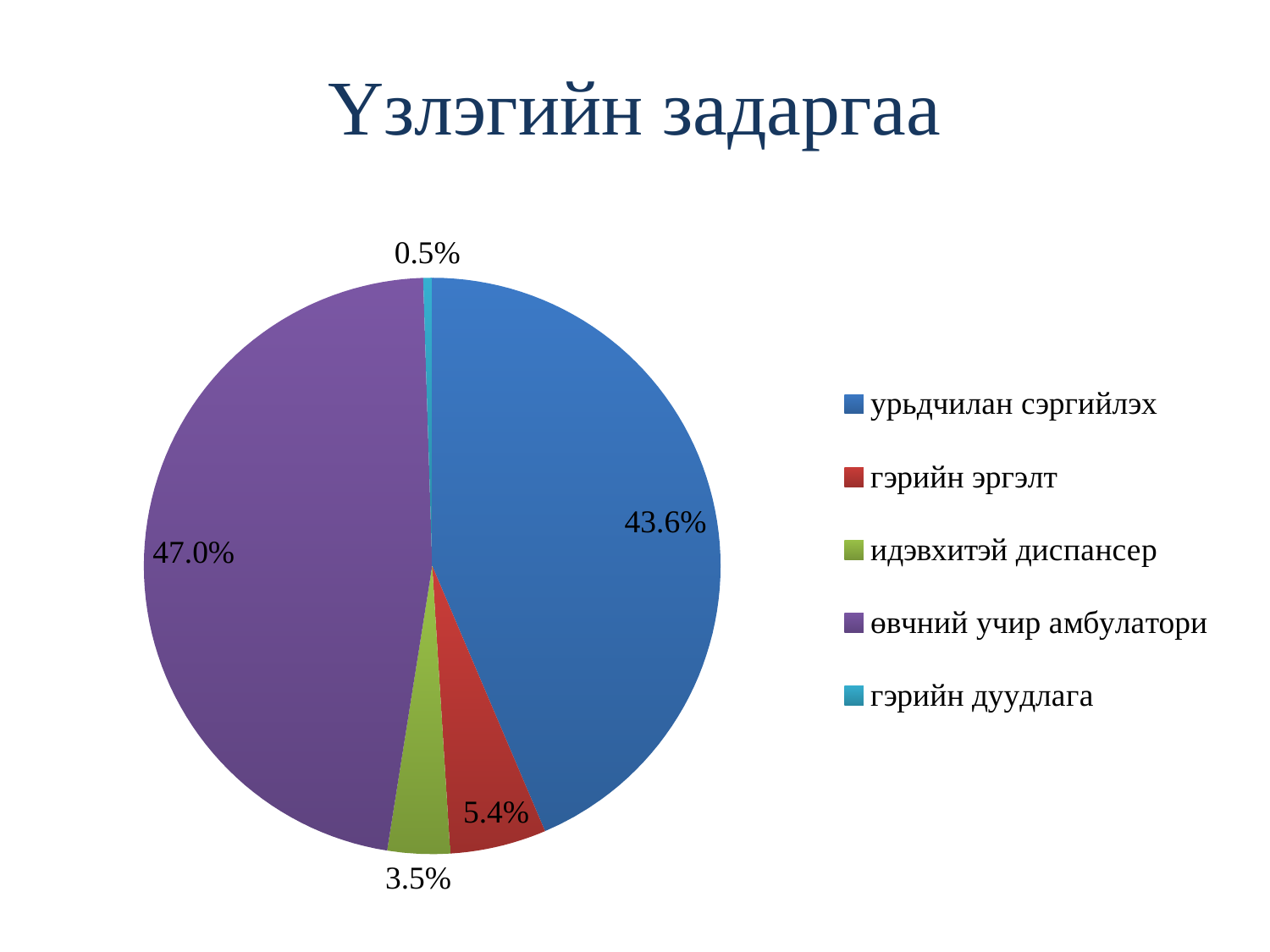
What share of the pie is урьдчилан сэргийлэх? 43.6% How many categories does the legend list? 5 What share of the pie is идэвхитэй диспансер? 3.5% Which category has the smallest share of the pie? гэрийн дуудлага What share of the pie is гэрийн эргэлт? 5.4% What kind of chart is shown on the slide? pie chart Which category has the largest share of the pie? өвчний учир амбулатори What share of the pie is гэрийн дуудлага? 0.5% What share of the pie is өвчний учир амбулатори? 47.0% What is the title of the chart? Үзлэгийн задаргаа What is the difference between the shares of өвчний учир амбулатори and урьдчилан сэргийлэх? 3.4% Which is larger, the share of гэрийн эргэлт or the share of идэвхитэй диспансер? гэрийн эргэлт